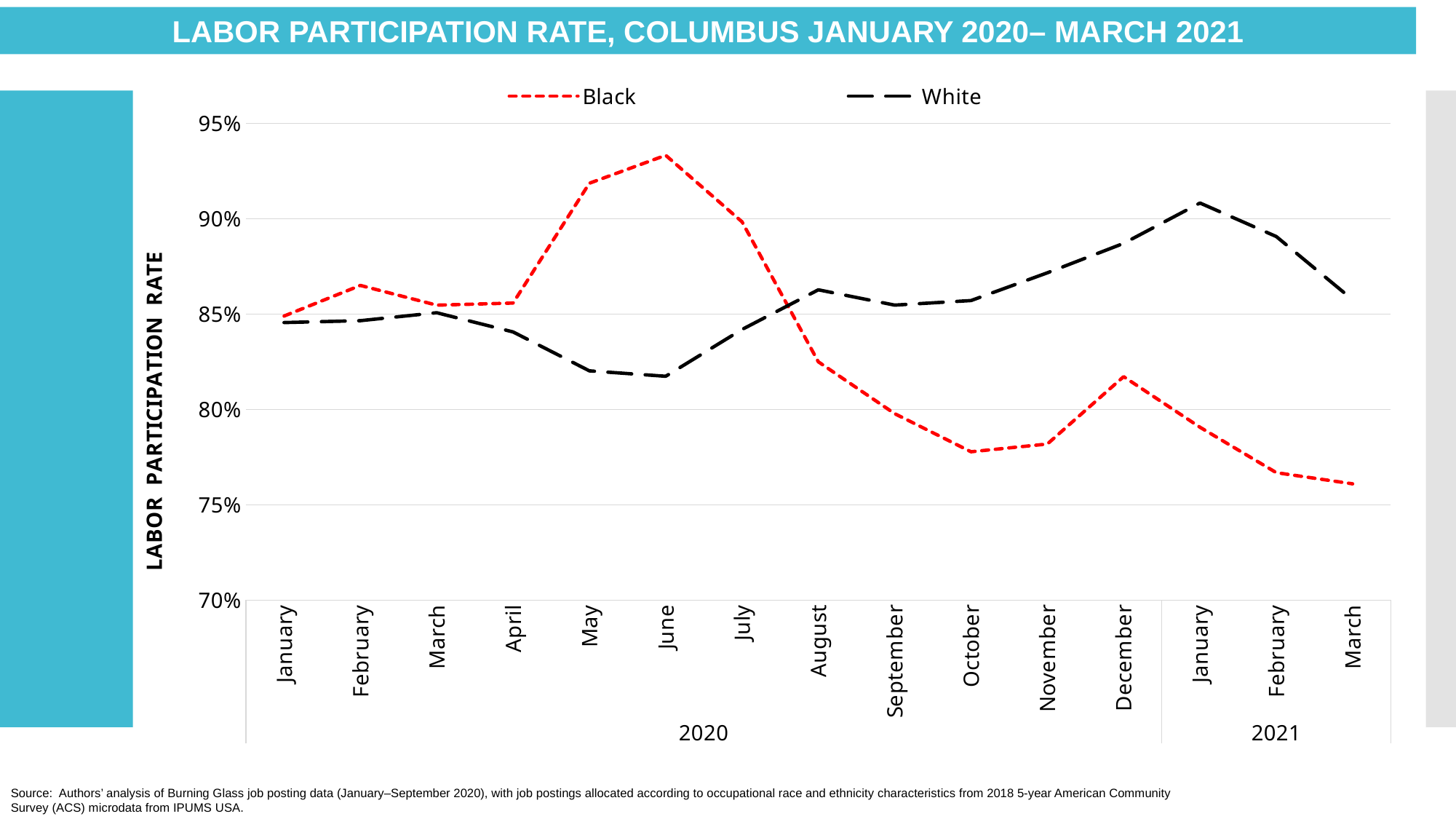
Is the Black labor participation rate in October 2020 greater or less than 80%? less What kind of chart is shown on the slide? line chart Is the Black labor participation rate in June 2020 greater or less than 90%? greater What colour is the line for the Black series? red In which month does the Black labor participation rate reach its highest point? June 2020 Does the Black labor participation rate rise or fall from June 2020 to October 2020? fall In March 2021, which series has the higher labor participation rate, Black or White? White How many series does the legend list? 2 How many months are plotted along the x axis? 15 In which month does the White labor participation rate reach its highest point? January 2021 Is the White labor participation rate in January 2021 greater or less than 90%? greater